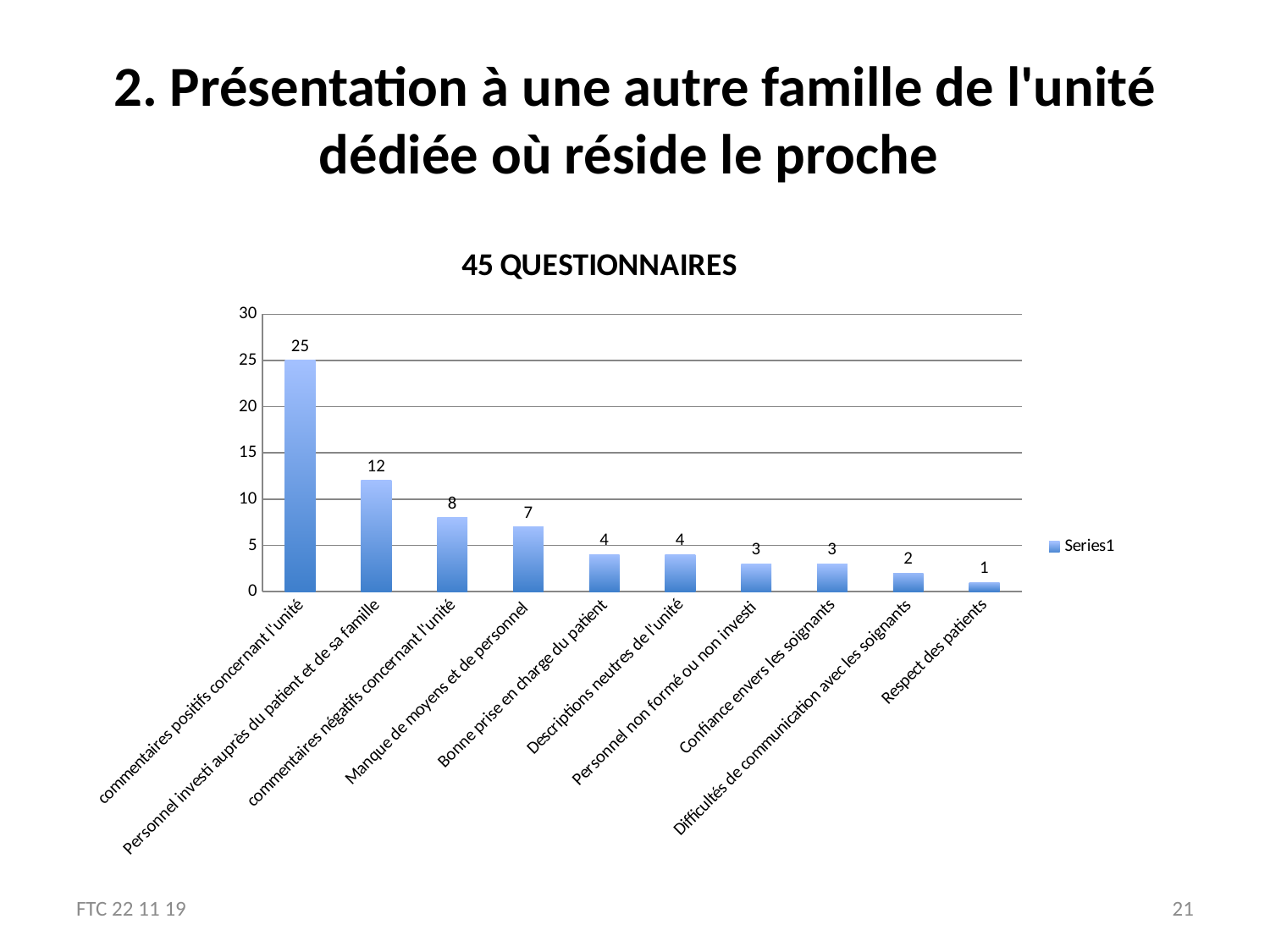
What is the difference between "commentaires positifs concernant l'unité" and "commentaires négatifs concernant l'unité"? 17 What is the value for "commentaires positifs concernant l'unité"? 25 Which is larger: "Personnel investi auprès du patient et de sa famille" or "commentaires négatifs concernant l'unité"? Personnel investi auprès du patient et de sa famille Which category has the lowest value? Respect des patients What kind of chart is shown? bar chart How many series does the legend list? 1 What is the title of the chart? 45 QUESTIONNAIRES What is the difference between "Personnel investi auprès du patient et de sa famille" and "Manque de moyens et de personnel"? 5 What is the value for "Difficultés de communication avec les soignants"? 2 How many categories are shown on the x axis? 10 What is the value for "Manque de moyens et de personnel"? 7 Which category has the highest value? commentaires positifs concernant l'unité